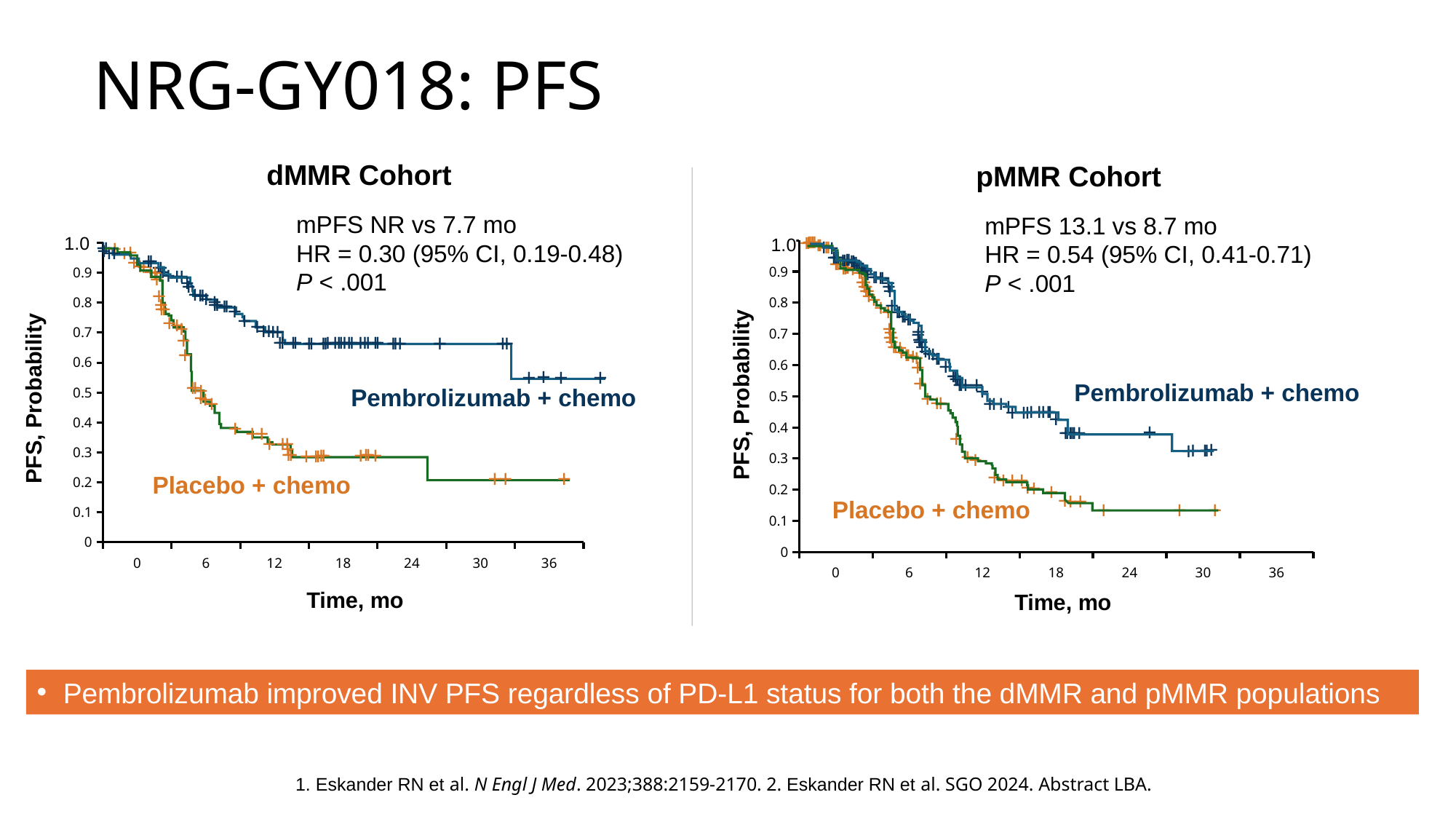
In the dMMR Cohort chart, is the PFS probability for Placebo + chemo at 24 months greater or less than 0.4? less In the pMMR Cohort chart, is the PFS probability for Pembrolizumab + chemo at 24 months greater or less than 0.5? less In the pMMR Cohort chart, do the PFS probability curves rise or fall as time increases? fall In the pMMR Cohort chart, what is the median PFS reported for the two arms? 13.1 vs 8.7 mo In the pMMR Cohort chart, which arm has the lower PFS probability at 18 months? Placebo + chemo In the dMMR Cohort chart, what is the median PFS reported for the two arms? NR vs 7.7 mo In the dMMR Cohort chart, which arm has the higher PFS probability at 12 months? Pembrolizumab + chemo In the dMMR Cohort chart, what hazard ratio is shown? HR = 0.30 (95% CI, 0.19-0.48) How many treatment arms are plotted in the pMMR Cohort chart? 2 In the pMMR Cohort chart, what hazard ratio is shown? HR = 0.54 (95% CI, 0.41-0.71) What kind of chart is the dMMR Cohort chart? Line chart (Kaplan-Meier curve) In the dMMR Cohort chart, is the PFS probability for Pembrolizumab + chemo at 24 months greater or less than 0.6? greater